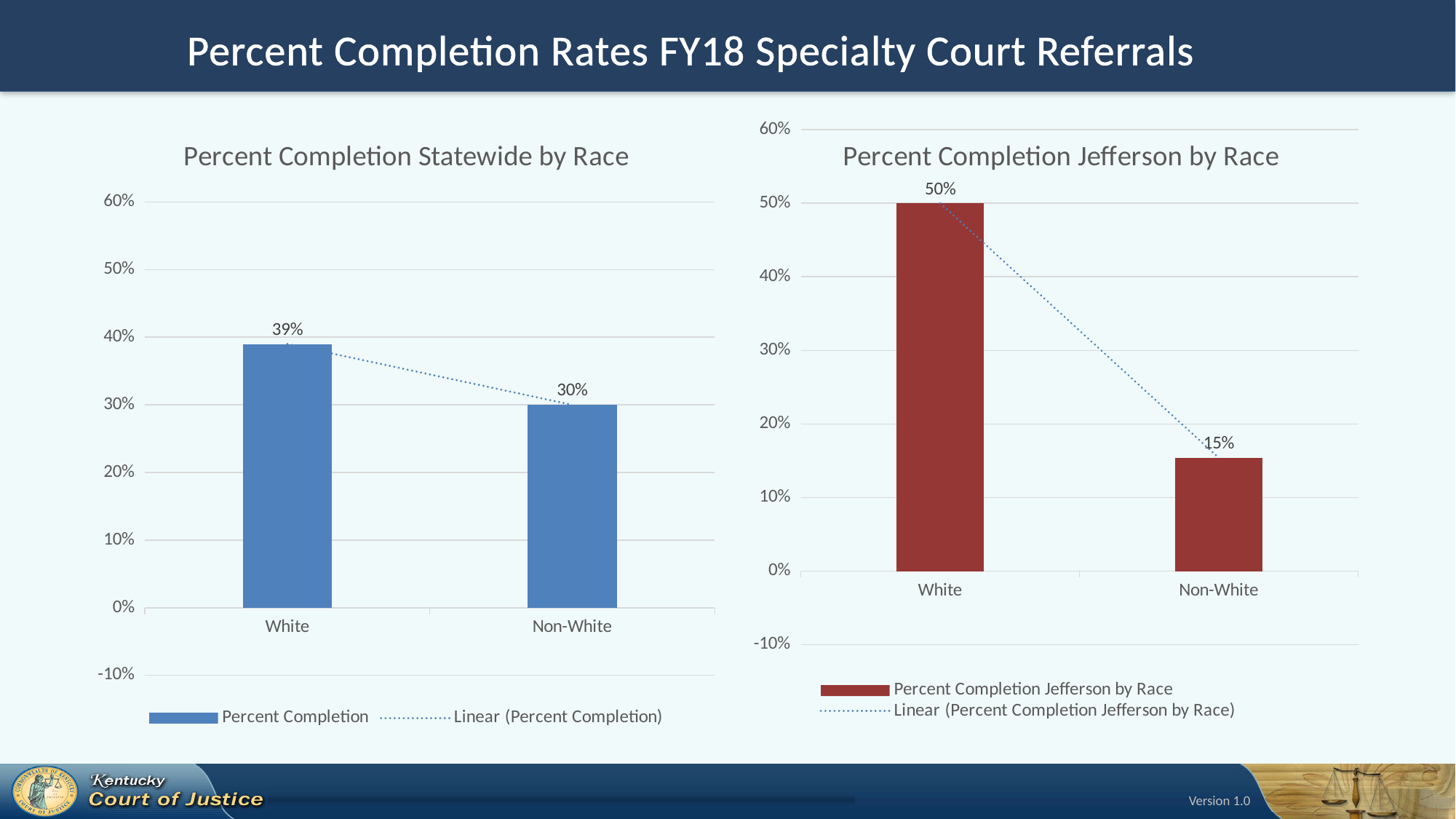
How many categories are shown on the x axis of the 'Percent Completion Statewide by Race' chart? 2 Is the White value in the 'Percent Completion Jefferson by Race' chart larger or smaller than the White value in the 'Percent Completion Statewide by Race' chart? larger What kind of chart is 'Percent Completion Jefferson by Race'? bar chart In the 'Percent Completion Jefferson by Race' chart, what is the difference between the White and Non-White values? 35% In the 'Percent Completion Statewide by Race' chart, which category has the lowest value? Non-White In the 'Percent Completion Statewide by Race' chart, what is the difference between the White and Non-White values? 9% In the 'Percent Completion Jefferson by Race' chart, what is the value for White? 50% In the 'Percent Completion Jefferson by Race' chart, what is the value for Non-White? 15% How many entries does the legend of the 'Percent Completion Jefferson by Race' chart list? 2 In the 'Percent Completion Statewide by Race' chart, what is the value for Non-White? 30% In the 'Percent Completion Statewide by Race' chart, what is the value for White? 39% In the 'Percent Completion Jefferson by Race' chart, which category has the highest value? White